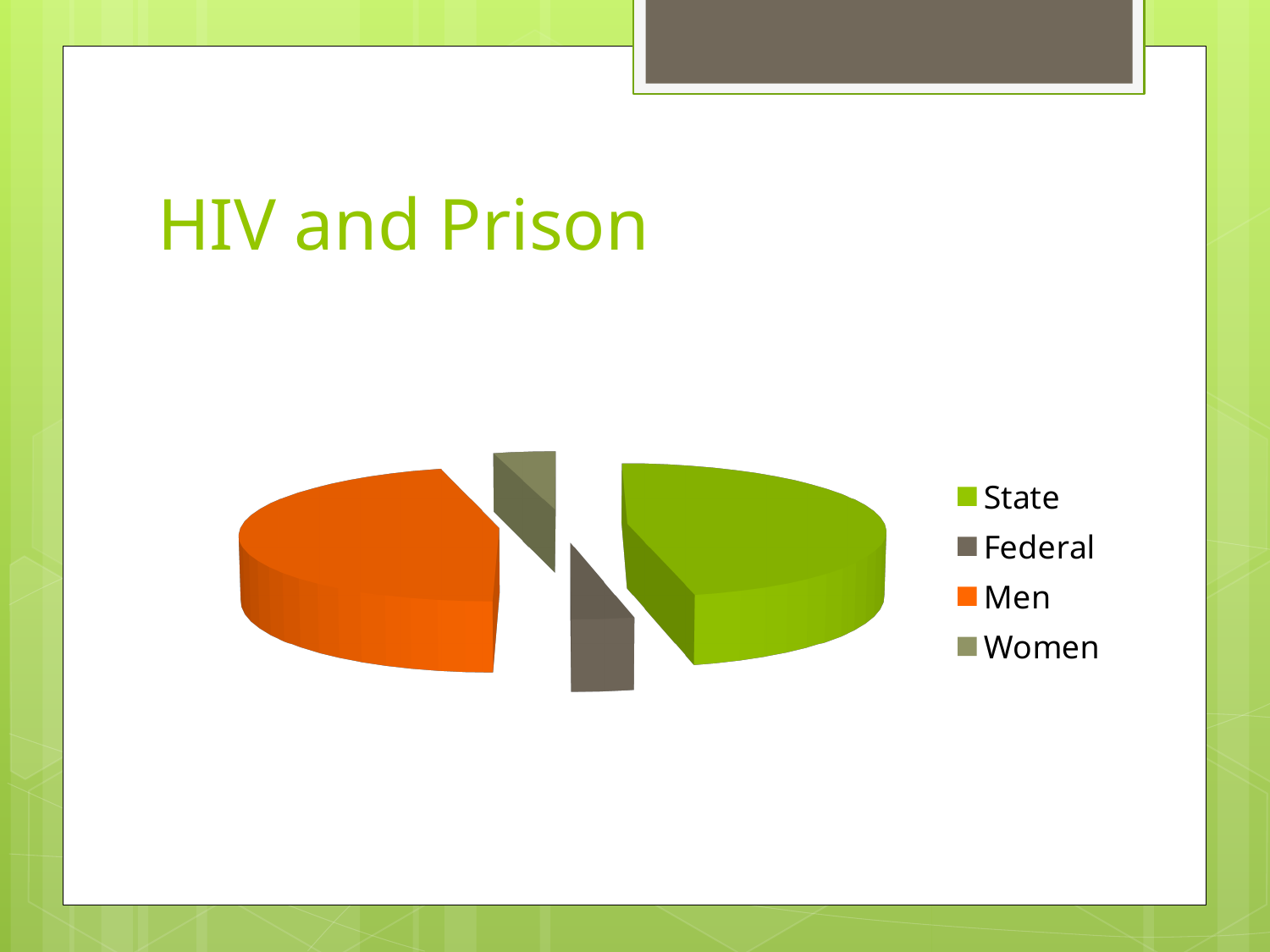
What is the title of the slide containing the pie chart? HIV and Prison What colour is the Men slice in the pie chart? orange Which is larger in the pie chart, the State slice or the Women slice? State How many slices does the pie chart have? 4 Which is larger in the pie chart, the State slice or the Federal slice? State Which is larger in the pie chart, the Men slice or the Women slice? Men How many entries does the legend of the pie chart list? 4 What kind of chart is shown on the slide? pie chart